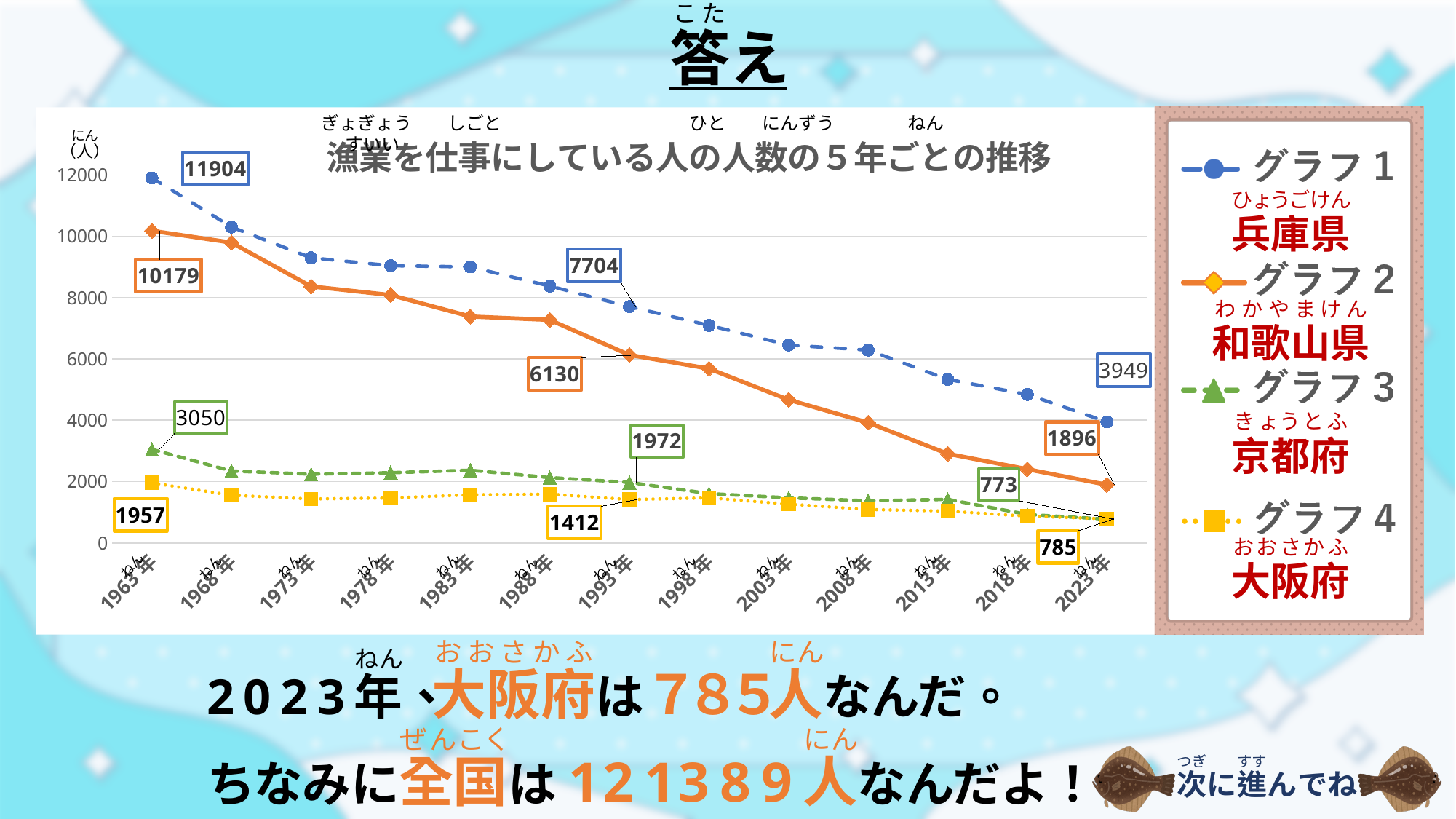
What is the value for 兵庫県 (グラフ1) in 1963年? 11904 Does the value for 兵庫県 rise or fall from 1963年 to 2023年? fall What kind of chart is shown on the slide? line chart What is the value for 大阪府 (グラフ4) in 2023年? 785 Which prefecture has the highest value in 2023年? 兵庫県 Which prefecture has the lowest value in 1963年? 大阪府 How many years are plotted along the x axis? 13 What is the value for 京都府 (グラフ3) in 1963年? 3050 How many series does the legend list? 4 What is the difference between the 兵庫県 value in 1963年 (11904) and in 2023年 (3949)? 7955 What is the value for 和歌山県 (グラフ2) in 1993年? 6130